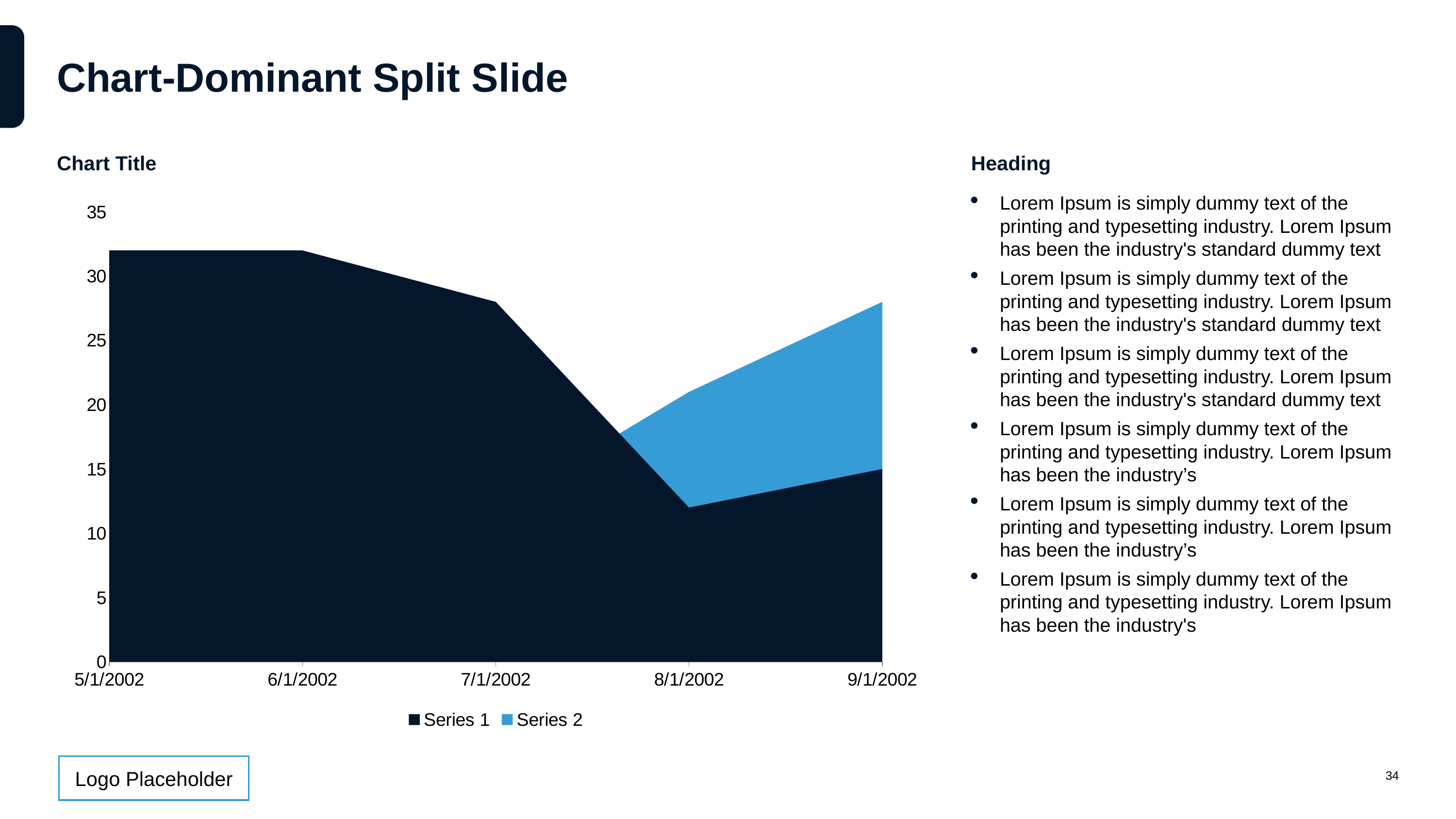
Does Series 1 rise or fall from 5/1/2002 to 8/1/2002? Fall Which series is drawn in light blue? Series 2 Is the value for Series 1 at 5/1/2002 greater or less than 30? greater At which date is Series 1 at its lowest? 8/1/2002 How many dates are shown on the x axis? 5 How many series does the legend list? 2 Is the value for Series 1 at 8/1/2002 greater or less than 15? less Is the value for Series 1 at 7/1/2002 greater or less than 25? greater What kind of chart is shown on the slide? Area chart At 9/1/2002, which is larger, Series 1 or Series 2? Series 2 What is the title of the chart? Chart Title